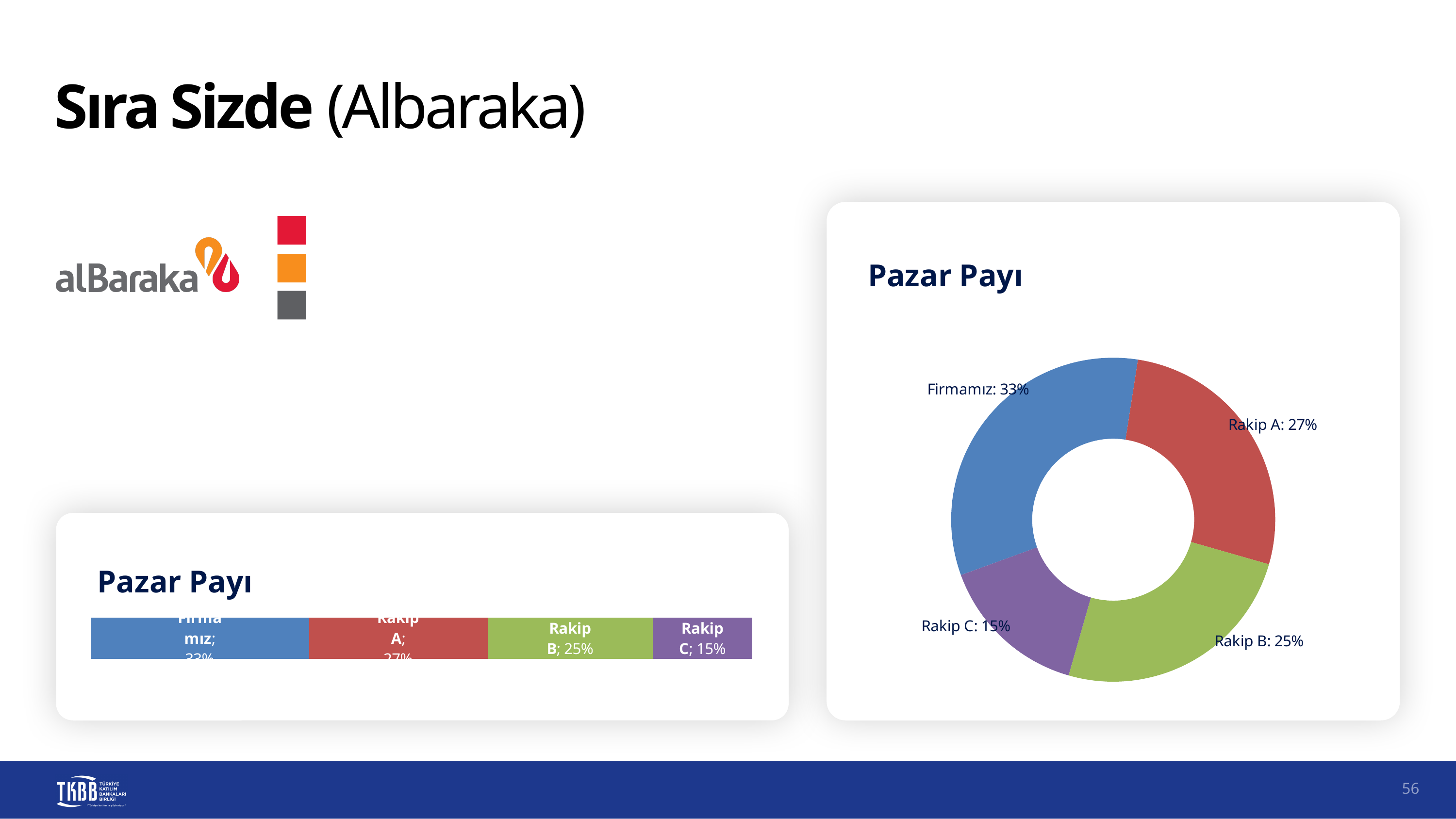
How many categories does the doughnut chart on the right show? 4 In the doughnut chart on the right, what is the difference between the shares of Firmamız and Rakip B? 8% In the doughnut chart on the right, which category has the smallest share? Rakip C In the stacked bar chart at the bottom left, what is the value for Rakip C? 15% In the stacked bar chart at the bottom left, what is the value for Rakip B? 25% In the doughnut chart on the right, which category has the largest share? Firmamız In the doughnut chart on the right, what is the value for Firmamız? 33% In the doughnut chart on the right, which is larger, Rakip A or Rakip C? Rakip A In the doughnut chart on the right, what is the value for Rakip A? 27% What kind of chart is the chart on the right of the slide? Doughnut chart What is the title of the doughnut chart on the right? Pazar Payı In the doughnut chart on the right, what is the value for Rakip C? 15%